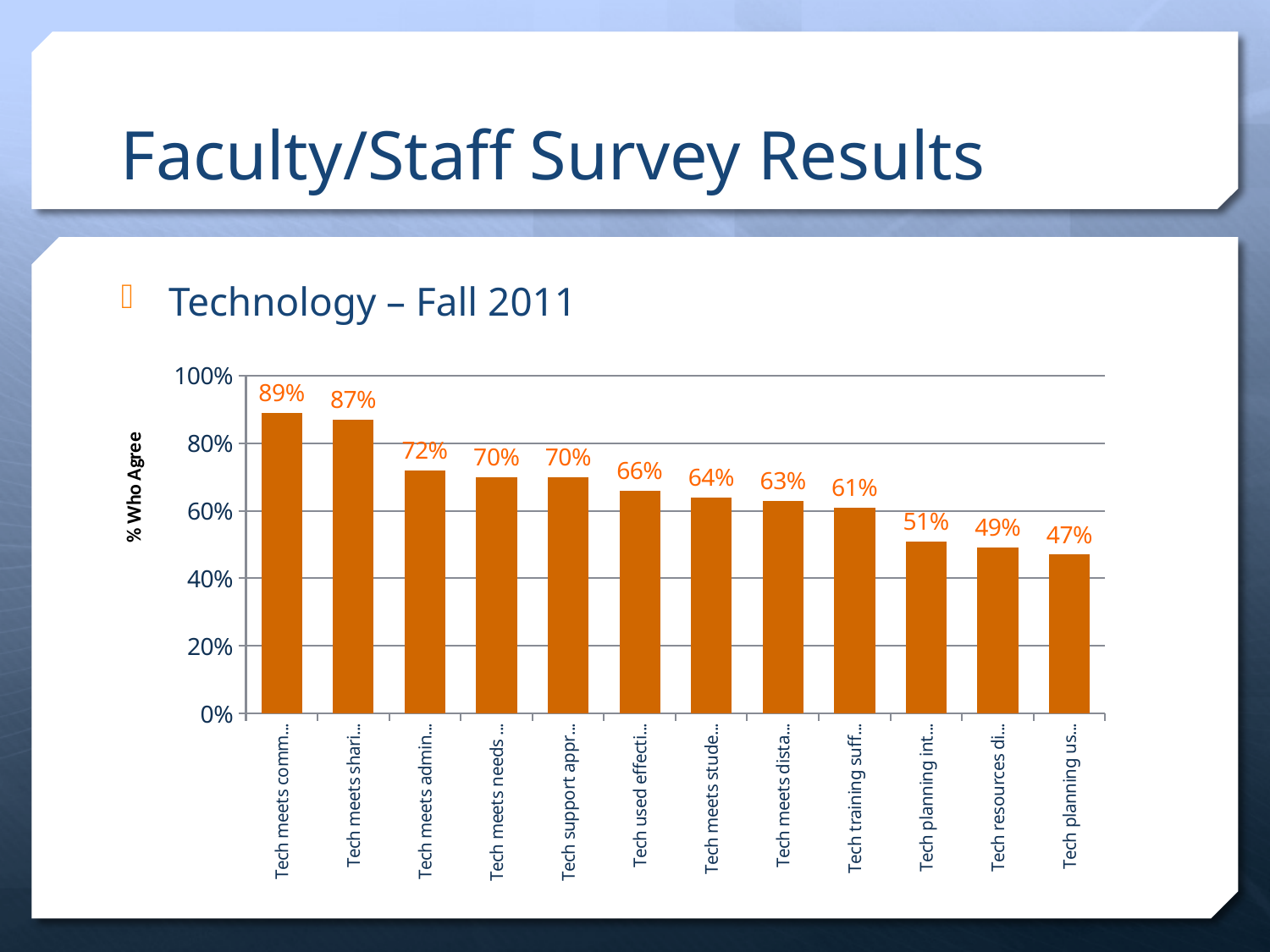
Do the bar values generally rise or fall from left to right across the chart? fall What is the subtitle shown above the chart? Technology – Fall 2011 What is the label of the vertical axis? % Who Agree Which is larger, the second bar from the left or the third bar from the left? the second bar (87%) What is the lowest value shown in the chart? 47% What type of chart is shown on the slide? bar chart How many bars (categories) are plotted in the chart? 12 What is the value of the bar labelled "Tech training suff…"? 61% What is the value of the last (rightmost) bar in the chart? 47% What is the value of the first (leftmost) bar in the chart? 89% What is the highest value shown in the chart? 89% What is the difference between the highest bar (89%) and the lowest bar (47%)? 42%